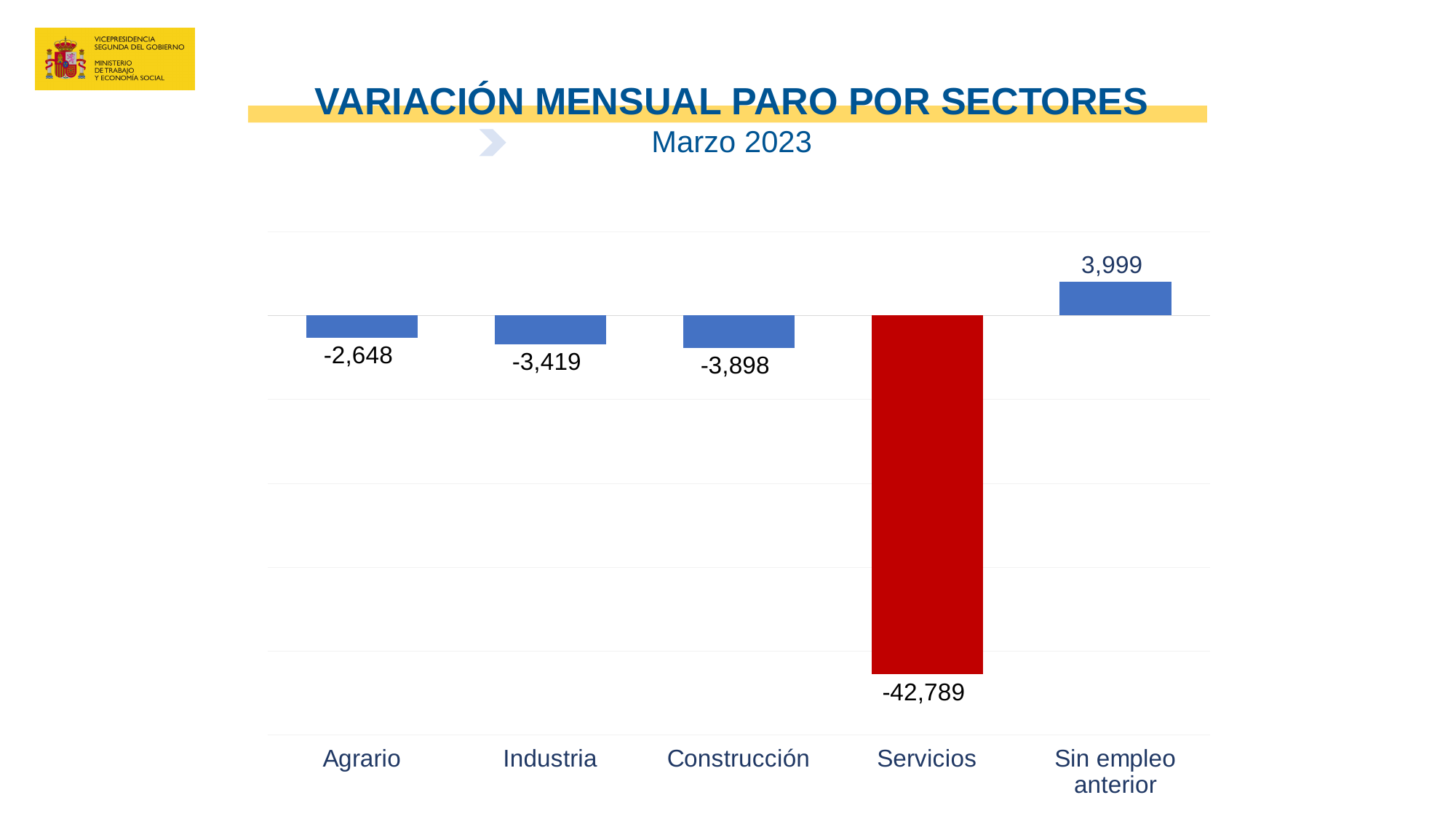
Which bar is coloured red rather than blue? Servicios How many sectors are shown in the chart? 5 What is the value for Agrario? -2,648 Which is larger, the value for Agrario or the value for Industria? Agrario What is the value for Servicios? -42,789 What is the difference between the values for Construcción and Industria? 479 What kind of chart is shown on the slide? Bar chart What is the value for Industria? -3,419 Which sector has the highest value? Sin empleo anterior What is the value for Sin empleo anterior? 3,999 What is the value for Construcción? -3,898 Which sector has the lowest value? Servicios